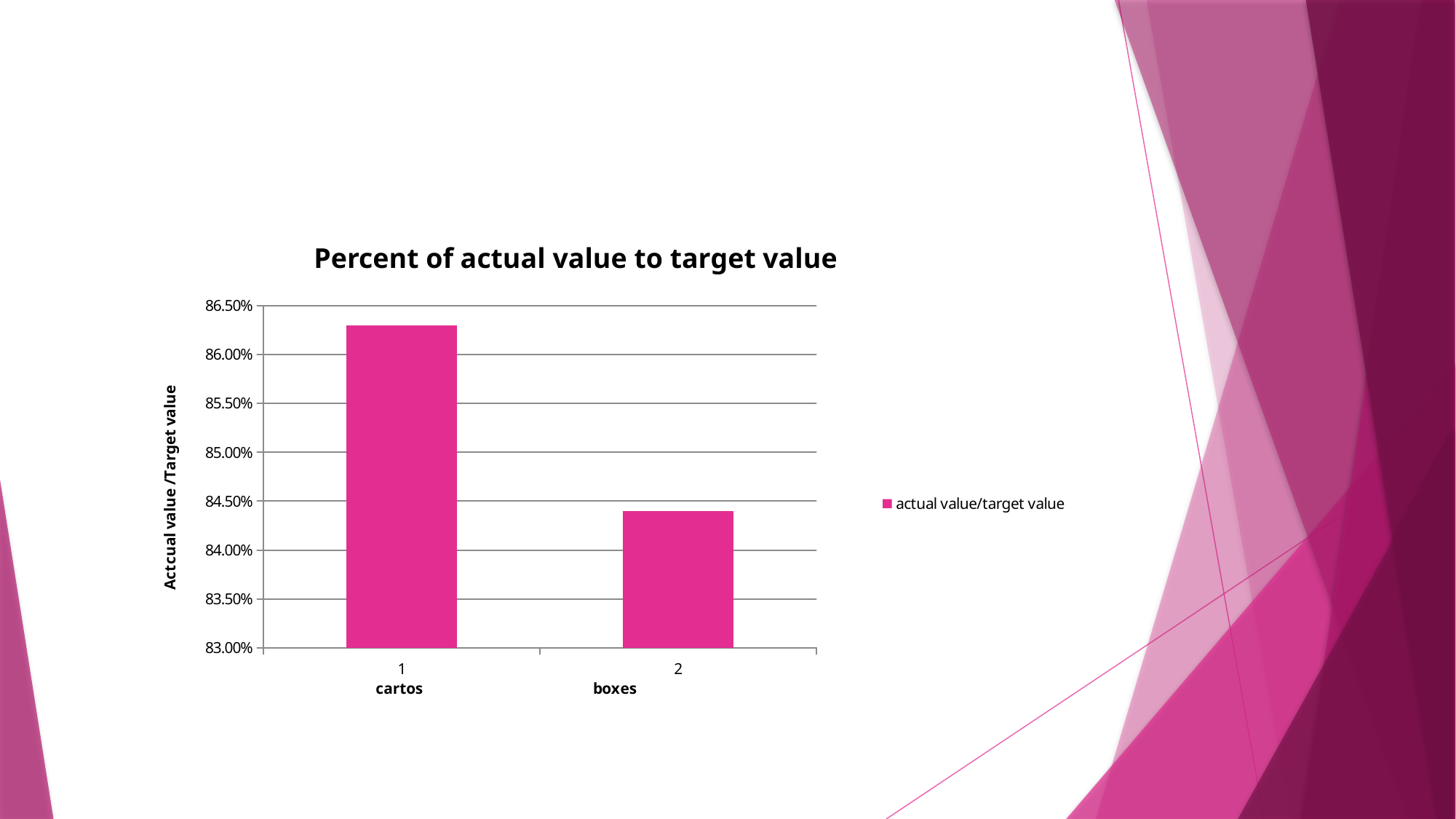
Which category has the highest value? cartos What is the legend entry for the series in the chart? actual value/target value Is the value for boxes greater or less than 84.50%? less Is the value for cartos greater or less than 86.00%? greater Which has a larger value, cartos or boxes? cartos How many series does the legend list? 1 What kind of chart is shown on the slide? bar chart Is the value for boxes greater or less than 84.00%? greater How many categories are plotted in the chart? 2 Do the values rise or fall from cartos to boxes along the x axis? fall Which category has the lowest value? boxes What is the title of the chart? Percent of actual value to target value